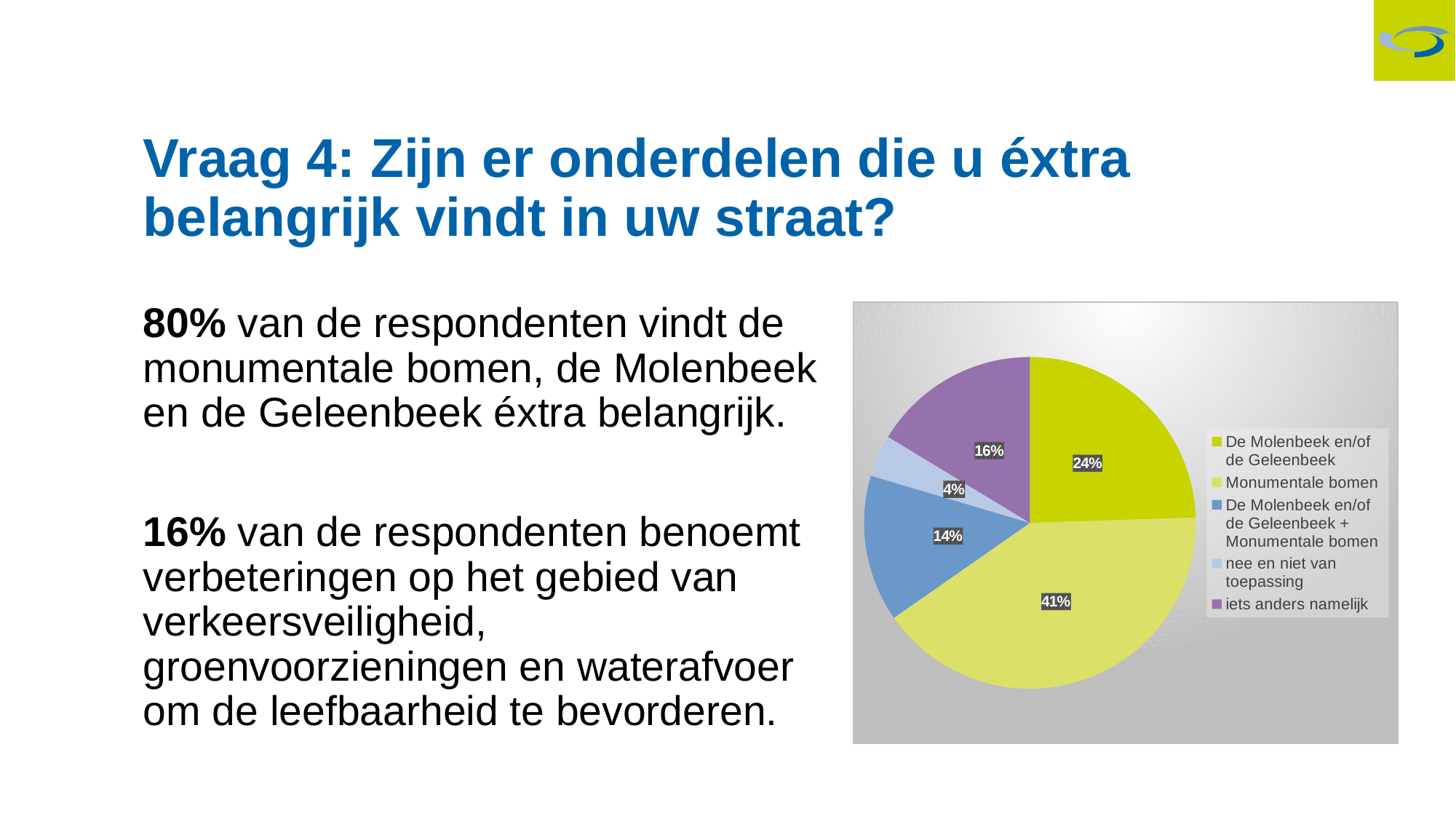
What share of the pie does 'Monumentale bomen' have? 41% Which category has the largest slice of the pie? Monumentale bomen What share of the pie does 'De Molenbeek en/of de Geleenbeek + Monumentale bomen' have? 14% What colour is the slice for 'iets anders namelijk'? purple Which is larger: the share for 'iets anders namelijk' or the share for 'De Molenbeek en/of de Geleenbeek + Monumentale bomen'? iets anders namelijk Which category has the smallest slice of the pie? nee en niet van toepassing What share of the pie does 'nee en niet van toepassing' have? 4% How many categories does the pie chart show? 5 What is the difference between the shares of 'Monumentale bomen' and 'De Molenbeek en/of de Geleenbeek'? 17% What kind of chart is shown on the slide? pie chart